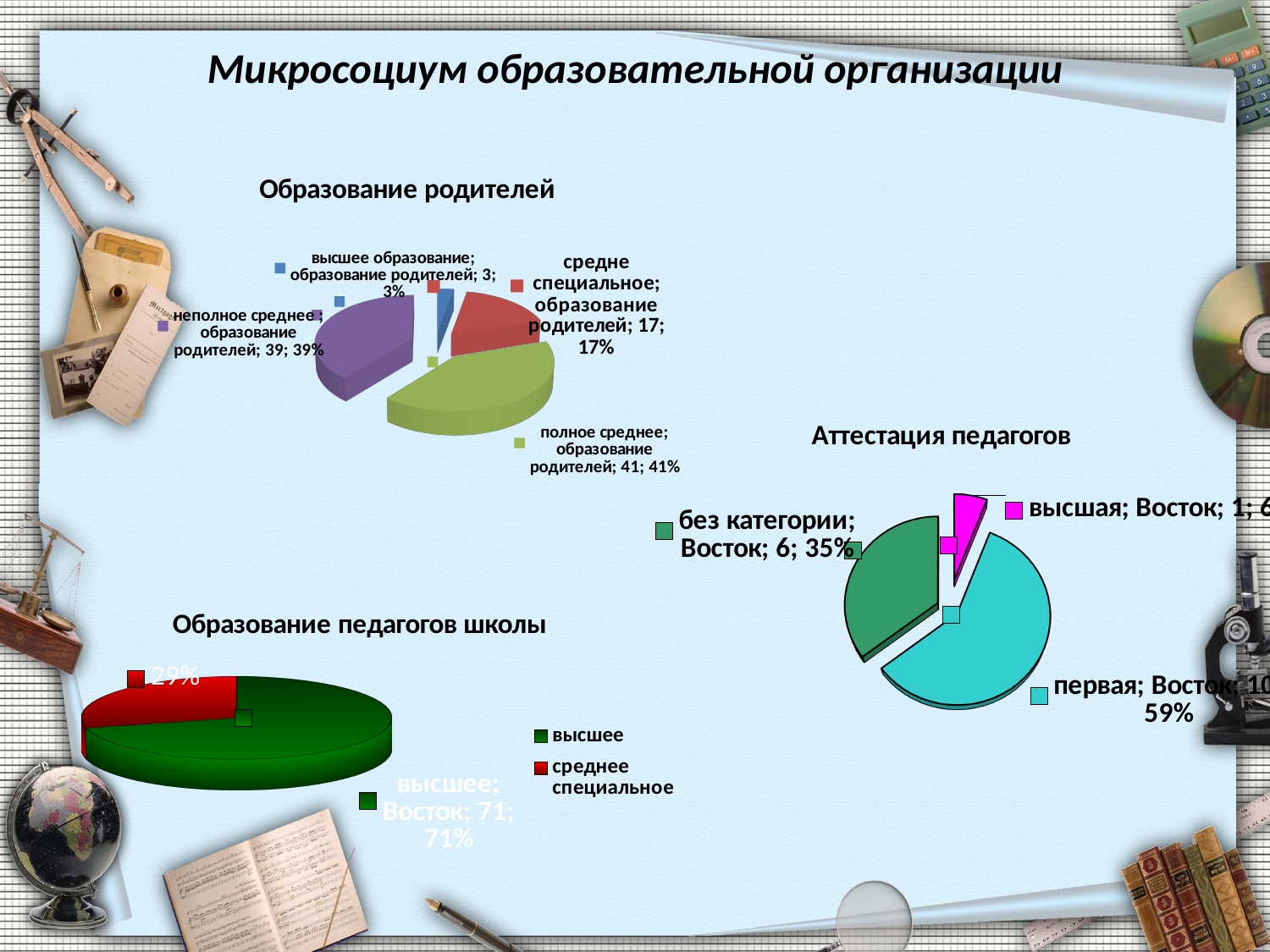
In the 'Образование родителей' chart, which category has the largest share? полное среднее In the 'Образование родителей' chart, what is the difference between the values for 'неполное среднее' and 'средне специальное'? 22 In the 'Образование родителей' chart, which category has the smallest share? высшее образование In the 'Образование родителей' chart, what value is shown for 'средне специальное'? 17 In the 'Образование педагогов школы' chart, which is larger: 'высшее' or 'среднее специальное'? высшее In the 'Образование педагогов школы' chart, what percentage is shown for 'высшее'? 71% In the 'Аттестация педагогов' chart, what percentage is shown for 'без категории'? 35% What type of chart is 'Образование педагогов школы'? pie chart In the 'Образование родителей' chart, what percentage is shown for 'полное среднее'? 41% In the 'Аттестация педагогов' chart, which category has the largest share? первая How many categories does the 'Образование родителей' chart show? 4 In the 'Аттестация педагогов' chart, what percentage is shown for 'первая'? 59%